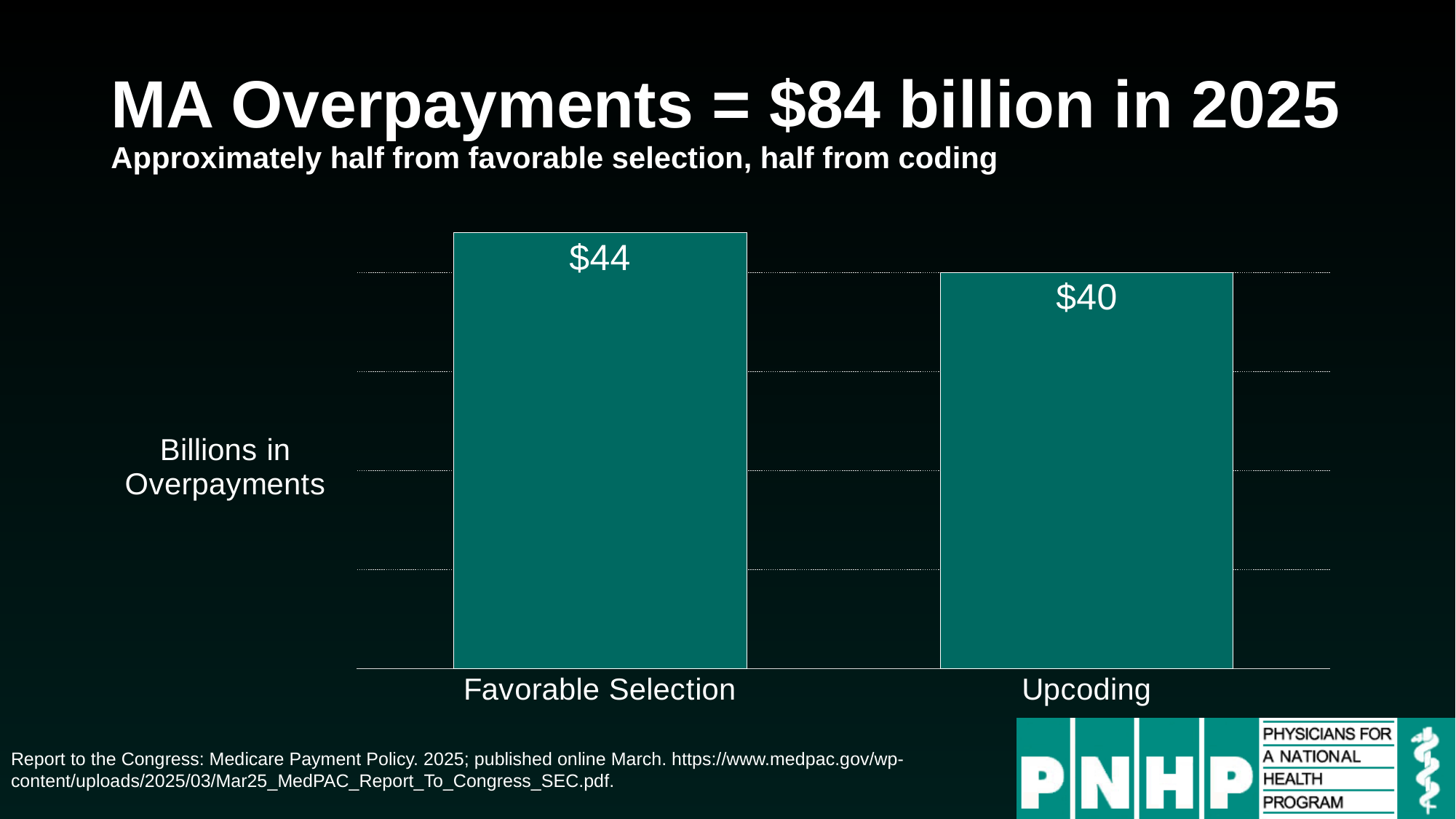
Which is larger, the value for Favorable Selection or the value for Upcoding? Favorable Selection Which category has the lowest value? Upcoding What is the label on the vertical axis of the chart? Billions in Overpayments Which category has the highest value? Favorable Selection What is the value for Favorable Selection? $44 What is the difference between the values for Favorable Selection and Upcoding? $4 What is the total of the two bars shown in the chart? $84 What kind of chart is shown on the slide? Bar chart How many categories are shown in the chart? 2 What is the title of the slide? MA Overpayments = $84 billion in 2025 What is the value for Upcoding? $40